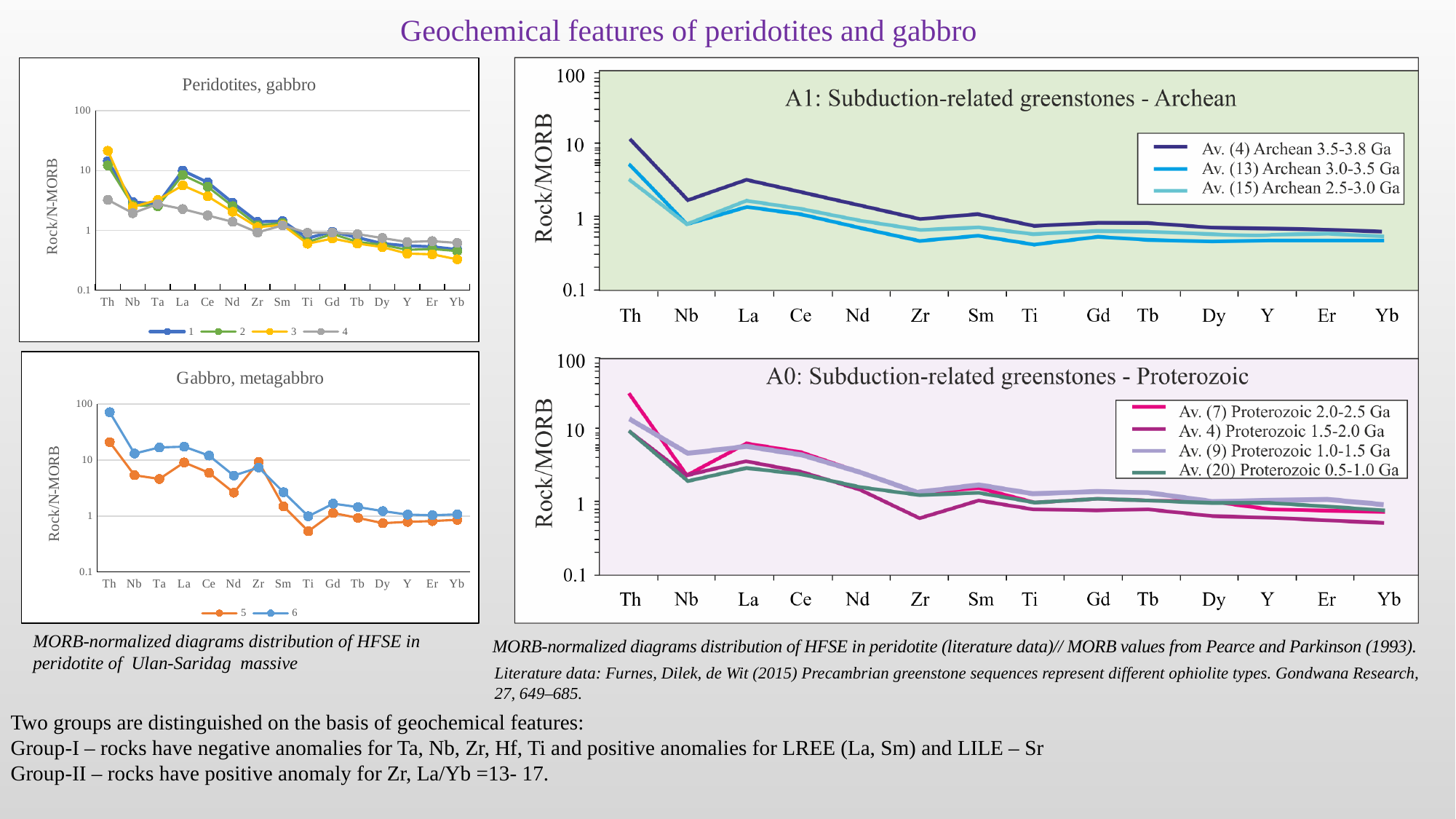
What is the y-axis label of the "A1: Subduction-related greenstones - Archean" chart? Rock/MORB What kind of chart is the "Peridotites, gabbro" chart? Line chart In the "Gabbro, metagabbro" chart, is the value of series 5 at Ti greater or less than 1? less How many elements are shown on the x axis of the "Peridotites, gabbro" chart? 15 How many series does the legend of the "Peridotites, gabbro" chart list? 4 How many elements are shown on the x axis of the "A1: Subduction-related greenstones - Archean" chart? 14 How many series does the legend of the "Gabbro, metagabbro" chart list? 2 In the "Gabbro, metagabbro" chart, is the value of series 6 at Th greater or less than 10? greater How many series does the legend of the "A1: Subduction-related greenstones - Archean" chart list? 3 In the "A0: Subduction-related greenstones - Proterozoic" chart, is the value of Av. (7) Proterozoic 2.0-2.5 Ga at Th greater or less than 10? greater In the "Gabbro, metagabbro" chart, at which element does series 6 reach its highest value? Th